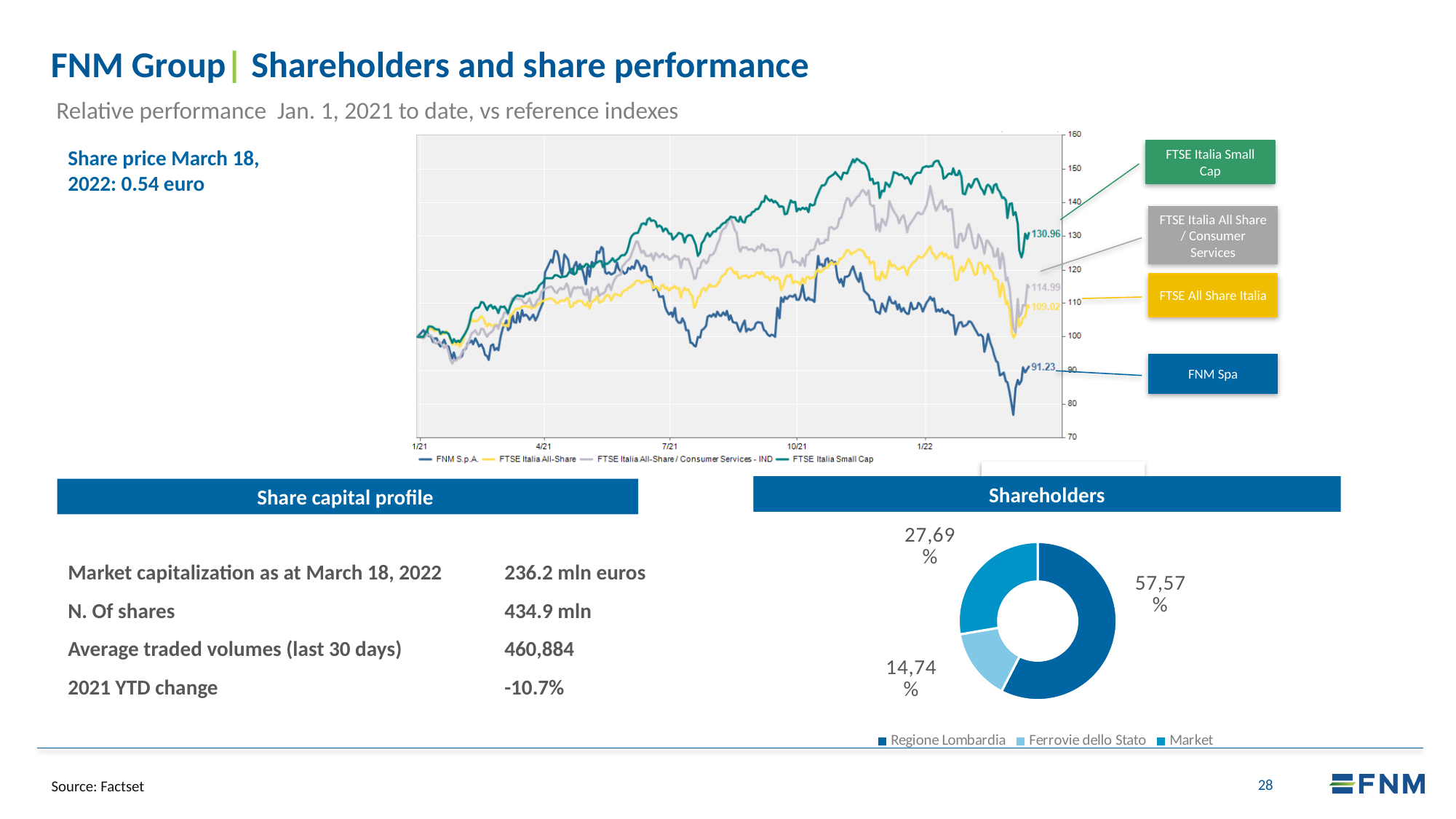
How many series does the legend of the relative performance line chart list? 4 In the Shareholders chart, what share does Regione Lombardia hold? 57,57% In the Shareholders chart, what share is held by the Market? 27,69% What kind of chart is the Shareholders chart? Doughnut chart In the relative performance line chart, which series ends higher, FTSE Italia All-Share or FNM S.p.A.? FTSE Italia All-Share In the Shareholders chart, which shareholder has the smallest share? Ferrovie dello Stato In the relative performance line chart, what is the final value shown for FNM S.p.A.? 91.23 In the Shareholders chart, what share does Ferrovie dello Stato hold? 14,74% In the Shareholders chart, how many percentage points larger is the Regione Lombardia share than the Market share? 29,88% In the relative performance line chart, what is the final value shown for FTSE Italia Small Cap? 130.96 In the Shareholders chart, which shareholder has the largest share? Regione Lombardia In the Shareholders chart, how many shareholder categories are shown? 3